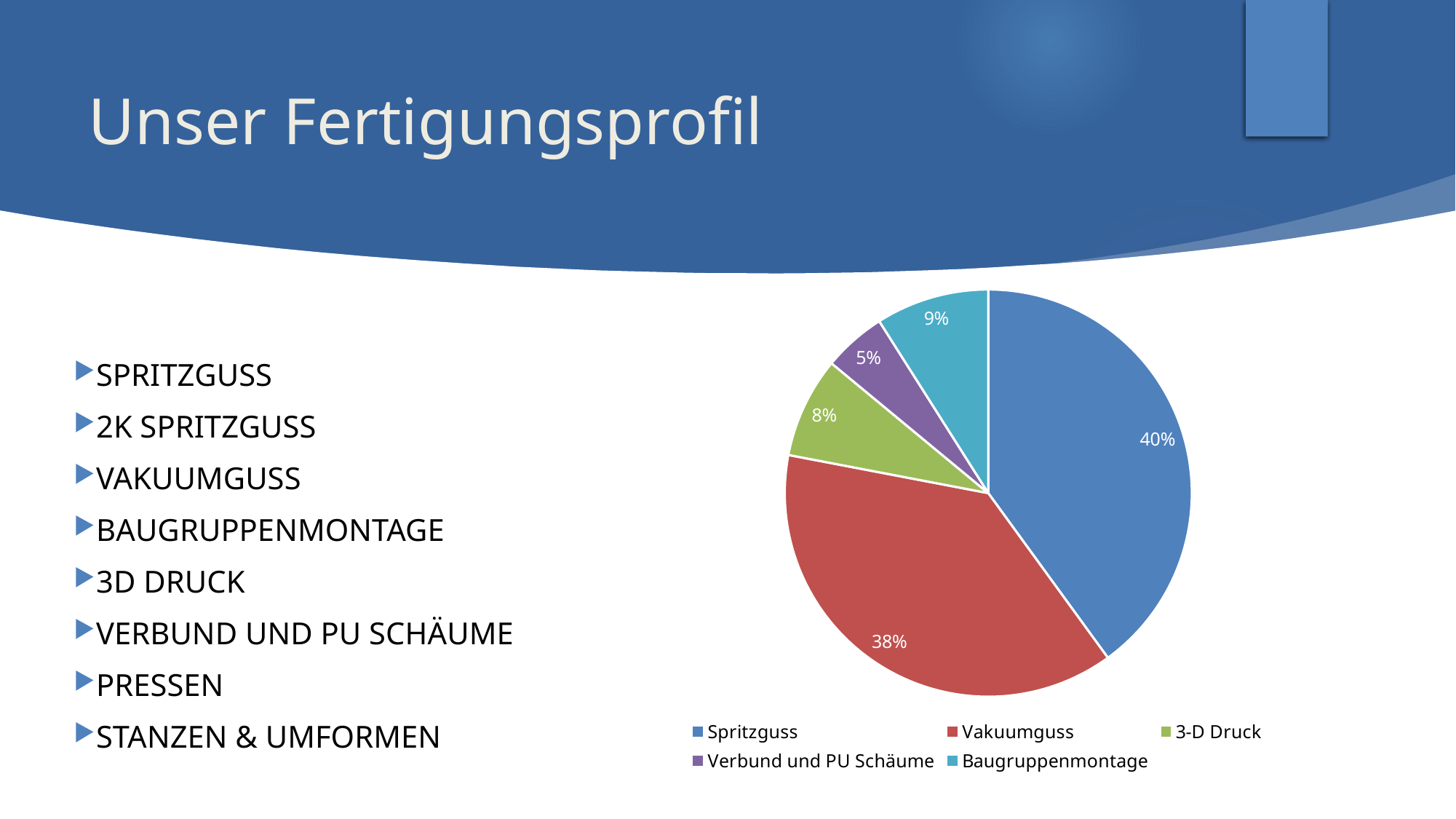
Which is larger, the share for Baugruppenmontage or the share for 3-D Druck? Baugruppenmontage Which category has the smallest slice of the pie? Verbund und PU Schäume What share of the pie does Spritzguss have? 40% What colour is the Vakuumguss slice in the pie chart? Red What share of the pie does Baugruppenmontage have? 9% Which category has the largest slice of the pie? Spritzguss How many slices does the pie chart have? 5 What share of the pie does 3-D Druck have? 8% What type of chart is shown on the slide? Pie chart What share of the pie does Verbund und PU Schäume have? 5% What share of the pie does Vakuumguss have? 38% What is the difference in percentage points between Spritzguss and Vakuumguss? 2